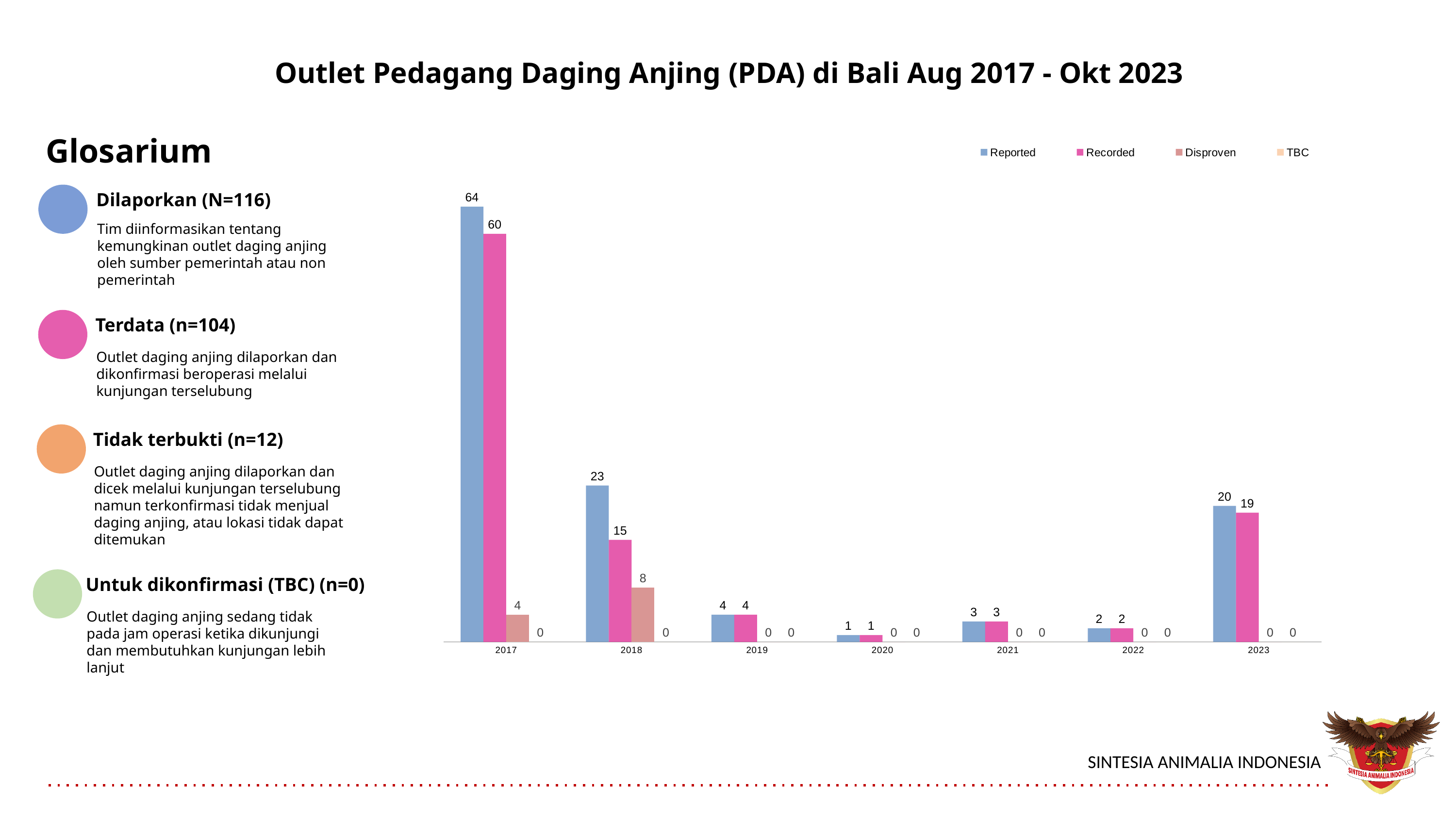
What is the Reported value for 2017? 64 What kind of chart is shown on the slide? Bar chart What is the Recorded value for 2023? 19 Which year has the lowest Reported value? 2020 How many years are shown on the x axis? 7 What is the Disproven value for 2018? 8 Which is larger, the Reported value for 2018 or the Reported value for 2023? Reported value for 2018 Which year has the highest Reported value? 2017 What is the difference between the Reported and Recorded values for 2017? 4 How many series does the legend list? 4 What is the title of the chart? Outlet Pedagang Daging Anjing (PDA) di Bali Aug 2017 - Okt 2023 What is the Recorded value for 2018? 15